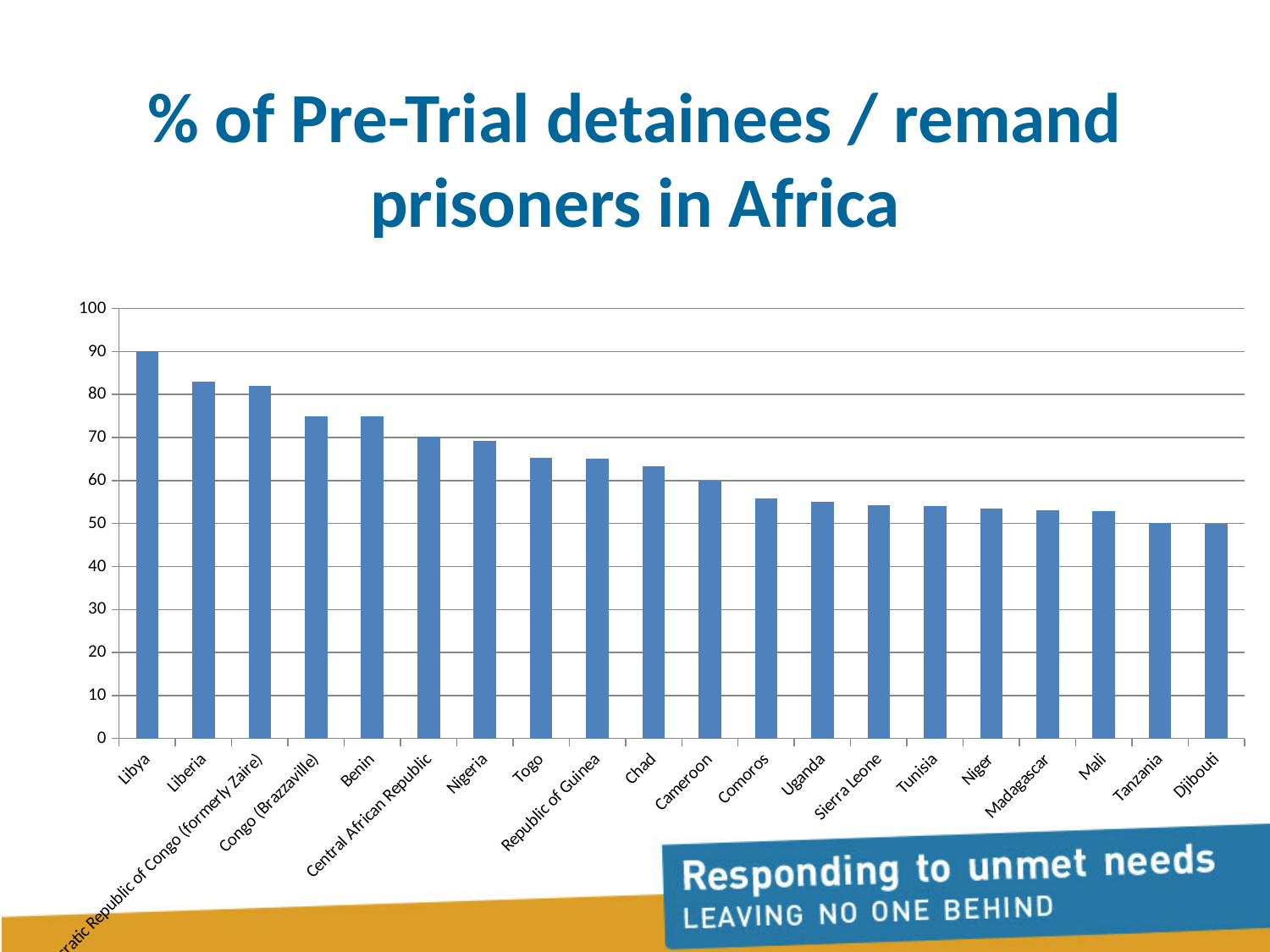
What is the title of the chart on the slide? % of Pre-Trial detainees / remand prisoners in Africa How many countries are shown in the chart? 20 Do the values rise or fall moving from left to right along the x axis? fall Is the value for Comoros greater or less than 50? greater Which country has the highest percentage of pre-trial detainees in the chart? Libya Is the value for Liberia greater or less than 80? greater Is the value for Chad greater or less than 70? less Which has the larger value, Liberia or Chad? Liberia What kind of chart is shown on the slide? bar chart